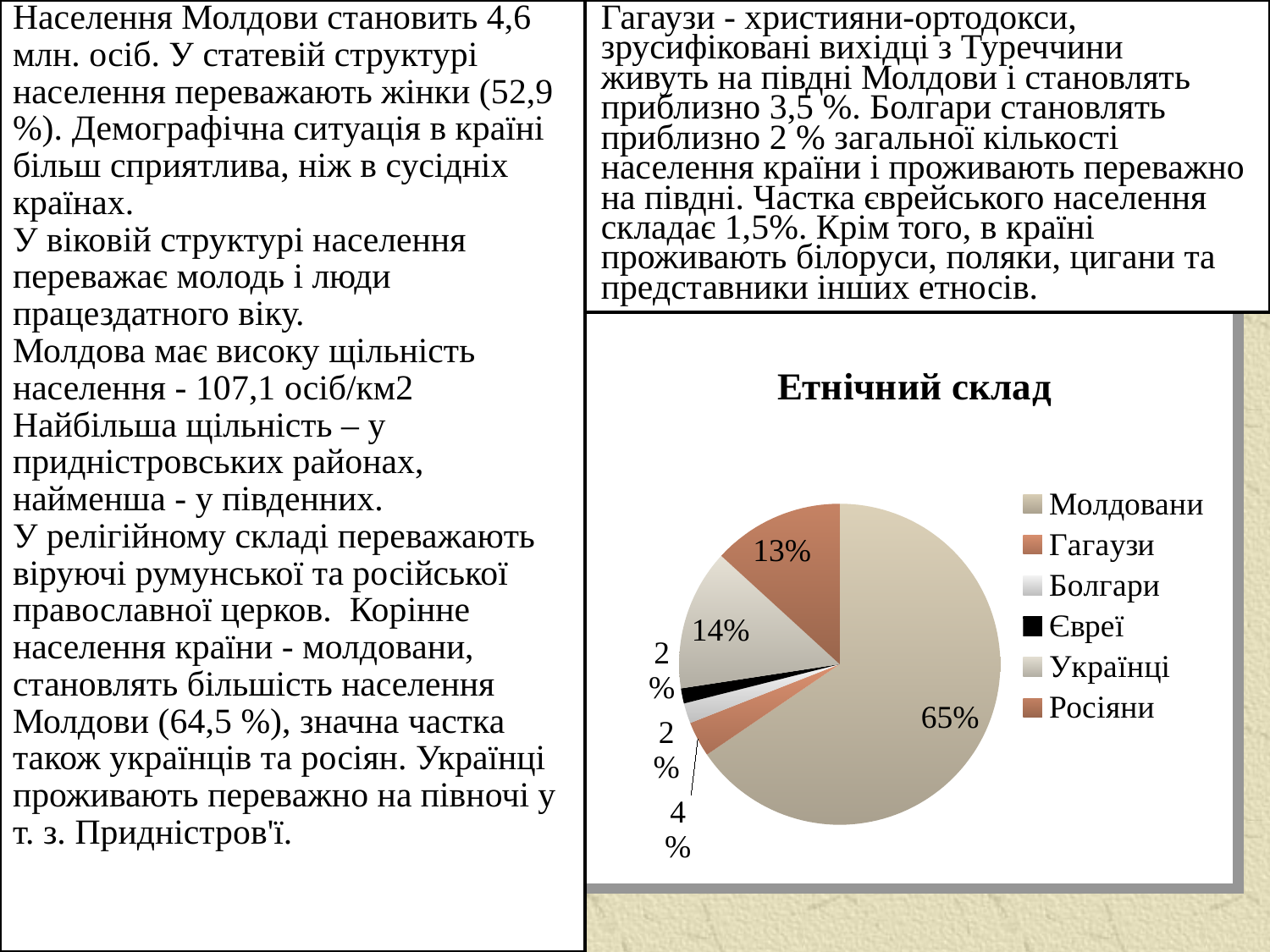
Which ethnic group has the largest slice of the pie? Молдовани What is the value shown for Українці? 14% What is the value shown for Гагаузи? 4% What share of the pie does Молдовани hold? 65% What is the value shown for Євреї? 2% What is the title of the chart? Етнічний склад What is the value shown for Росіяни? 13% What type of chart is shown on the slide? pie chart Which is larger, the share for Українці or the share for Росіяни? Українці How many ethnic groups are listed in the chart legend? 6 Which ethnic group is shown in black in the pie chart? Євреї What is the difference between the share for Молдовани and the share for Росіяни? 52 percentage points